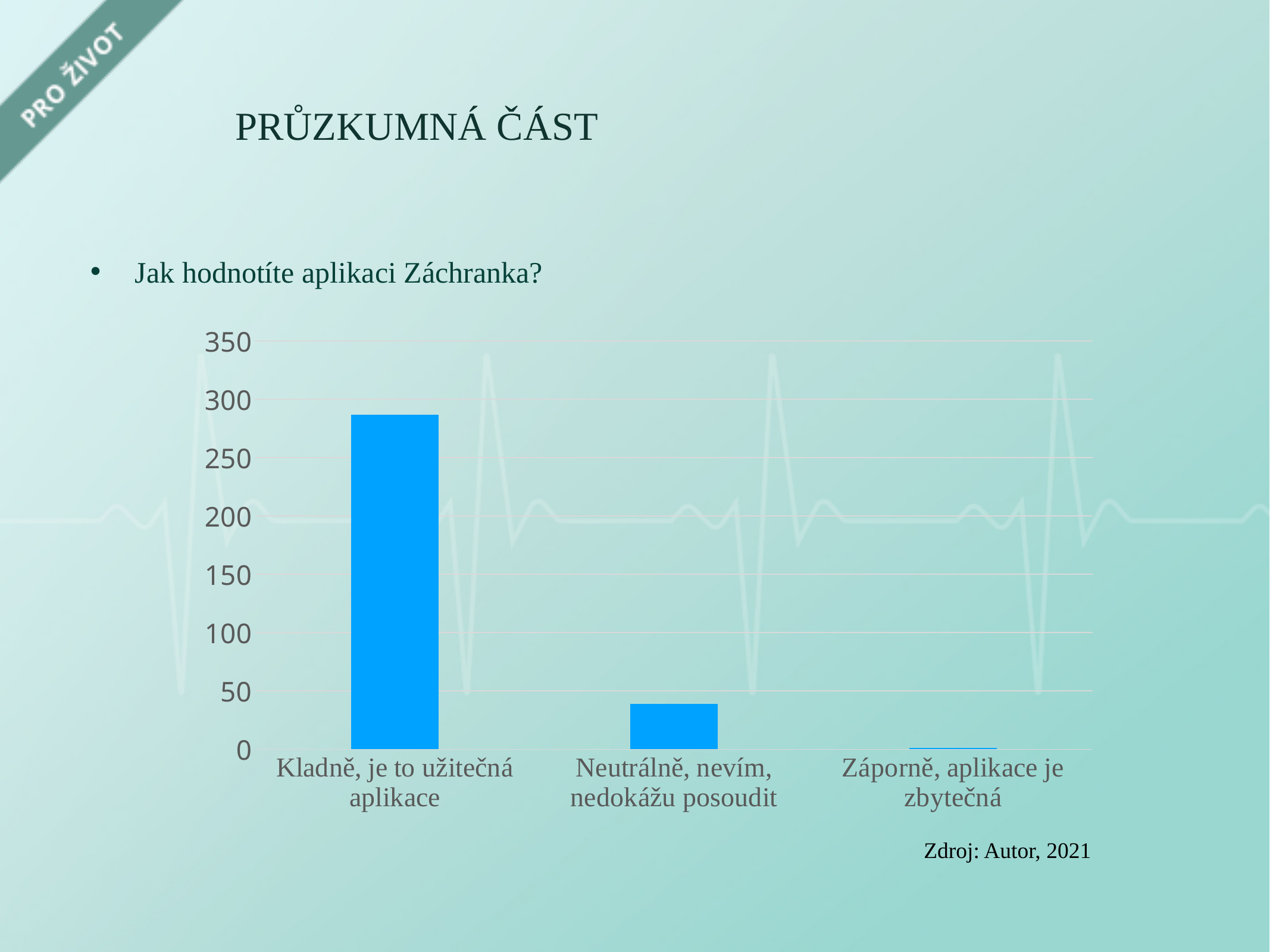
Is the value for "Neutrálně, nevím, nedokážu posoudit" greater or less than 50? less Which is larger: the value for "Kladně, je to užitečná aplikace" or the value for "Neutrálně, nevím, nedokážu posoudit"? Kladně, je to užitečná aplikace Which category has the highest value in the chart? Kladně, je to užitečná aplikace What survey question does the chart on the slide present results for? Jak hodnotíte aplikaci Záchranka? Which category has the lowest value in the chart? Záporně, aplikace je zbytečná What kind of chart is shown on the slide? bar chart Which is larger: the value for "Neutrálně, nevím, nedokážu posoudit" or the value for "Záporně, aplikace je zbytečná"? Neutrálně, nevím, nedokážu posoudit Is the value for "Kladně, je to užitečná aplikace" greater or less than 300? less Is the value for "Kladně, je to užitečná aplikace" greater or less than 250? greater Do the values rise or fall from left to right across the categories? fall How many categories are shown on the x axis of the chart? 3